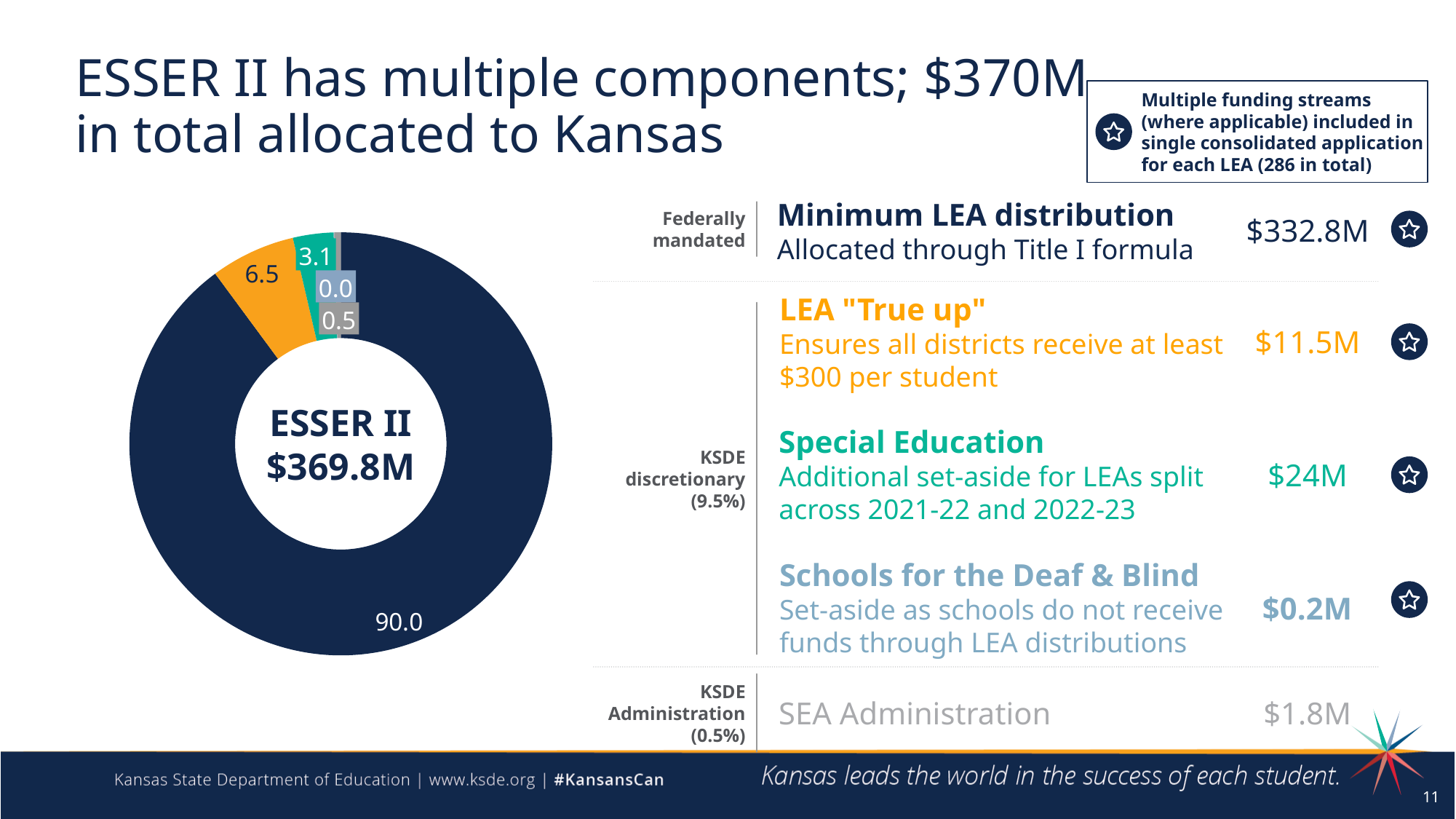
What type of chart is shown on the left of the slide? Pie (donut) chart How many slices are labelled on the ESSER II donut chart? 5 What is the difference between the orange slice (6.5) and the teal slice (3.1) on the ESSER II donut chart? 3.4 What is the value labelled on the largest slice of the ESSER II donut chart? 90.0 Which slice is larger on the ESSER II donut chart, the orange slice or the teal slice? The orange slice (6.5) What value is labelled on the orange slice of the ESSER II donut chart? 6.5 What is the smallest value labelled on the ESSER II donut chart? 0.0 What value is labelled on the teal (green) slice of the ESSER II donut chart? 3.1 What value is labelled on the grey slice of the ESSER II donut chart? 0.5 What text is shown in the centre of the donut chart? ESSER II $369.8M What is the difference between the largest slice (90.0) and the orange slice (6.5) on the ESSER II donut chart? 83.5 What colour is the largest slice of the ESSER II donut chart? Dark navy blue